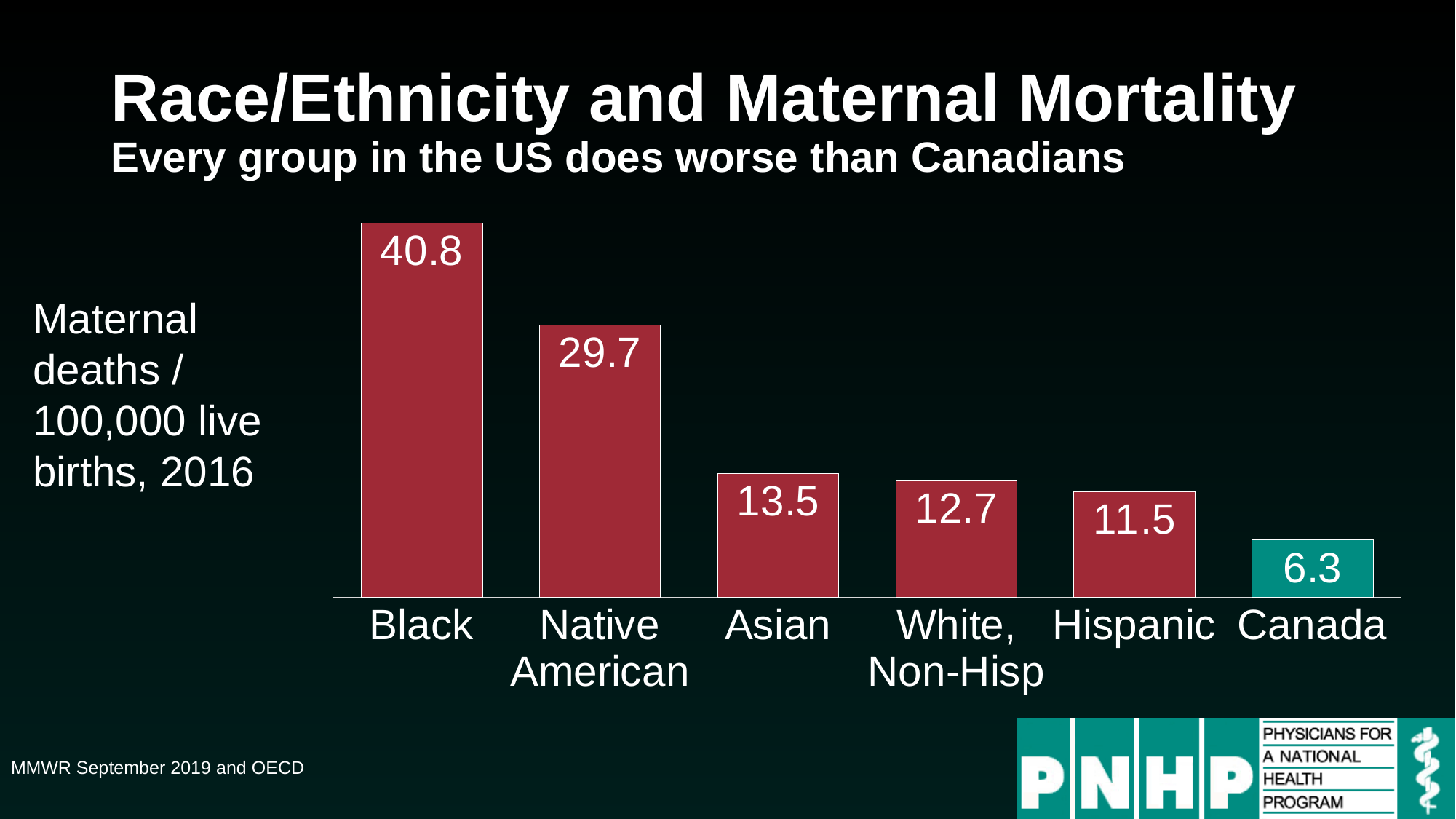
Which bar is shown in a different colour (teal) from the others? Canada What is the value shown for Hispanic? 11.5 What is the maternal mortality value for Canada? 6.3 What is the difference between the Black and Canada values? 34.5 Which category has the highest maternal mortality? Black How many categories are shown in the chart? 6 What is the maternal mortality value for Black? 40.8 What is the difference between the Native American and Asian values? 16.2 What is the value shown for Native American? 29.7 Which is larger, the value for Asian or the value for White, Non-Hisp? Asian Which category has the lowest maternal mortality? Canada What kind of chart is shown on the slide? Bar chart